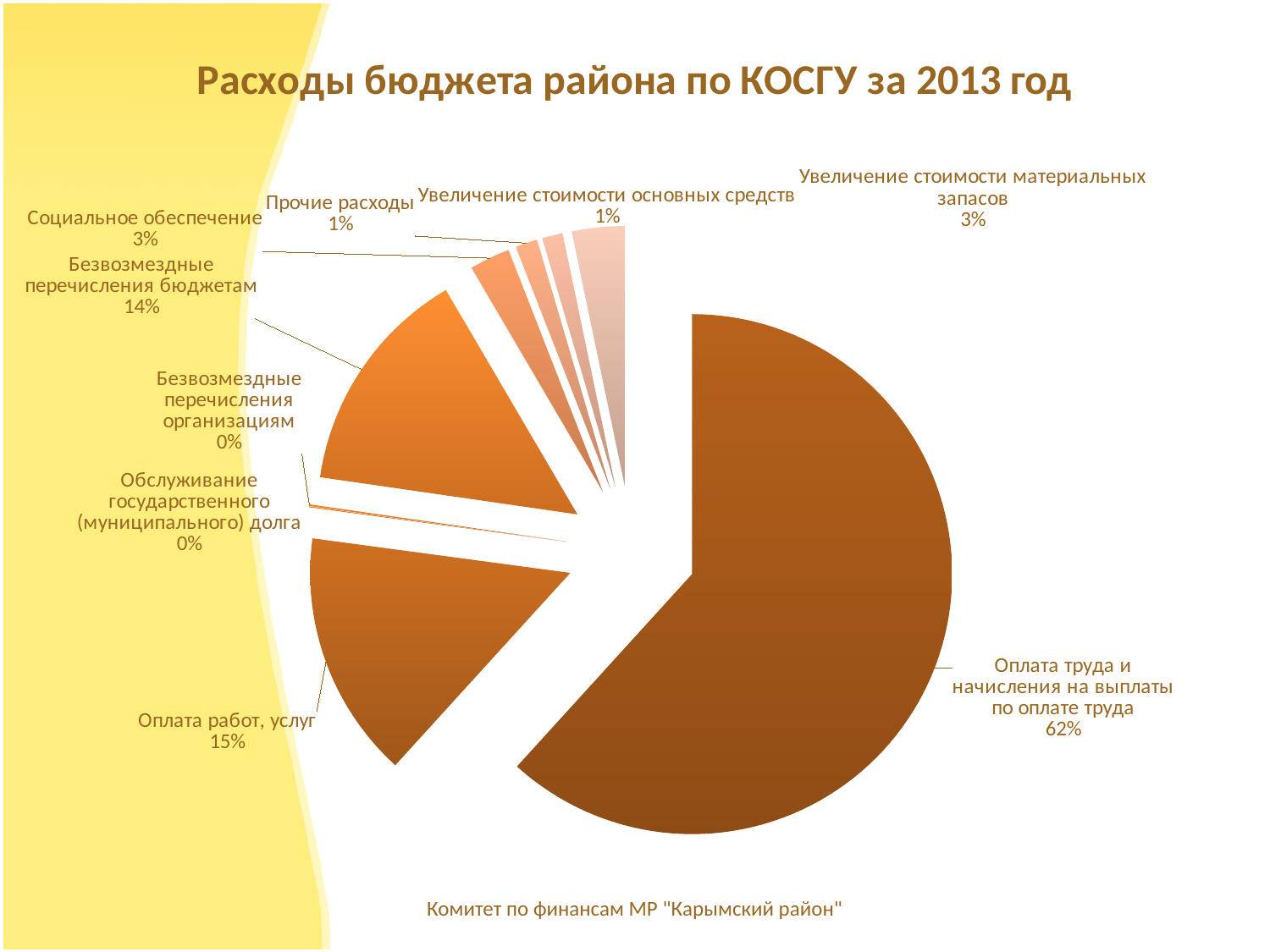
Что больше: доля «Оплата работ, услуг» или доля «Безвозмездные перечисления бюджетам»? Оплата работ, услуг Какова доля категории «Прочие расходы»? 1% Какая категория имеет наибольшую долю расходов? Оплата труда и начисления на выплаты по оплате труда Какова доля категории «Увеличение стоимости материальных запасов»? 3% Как называется диаграмма на слайде? Расходы бюджета района по КОСГУ за 2013 год Сколько категорий расходов показано на диаграмме? 9 Какой тип диаграммы показан на слайде? Круговая диаграмма Какова доля категории «Обслуживание государственного (муниципального) долга»? 0% Какова доля категории «Оплата труда и начисления на выплаты по оплате труда»? 62% Какова доля категории «Безвозмездные перечисления бюджетам»? 14% На сколько процентных пунктов доля «Оплата труда и начисления на выплаты по оплате труда» больше доли «Оплата работ, услуг»? 47 Какова доля категории «Оплата работ, услуг»? 15%